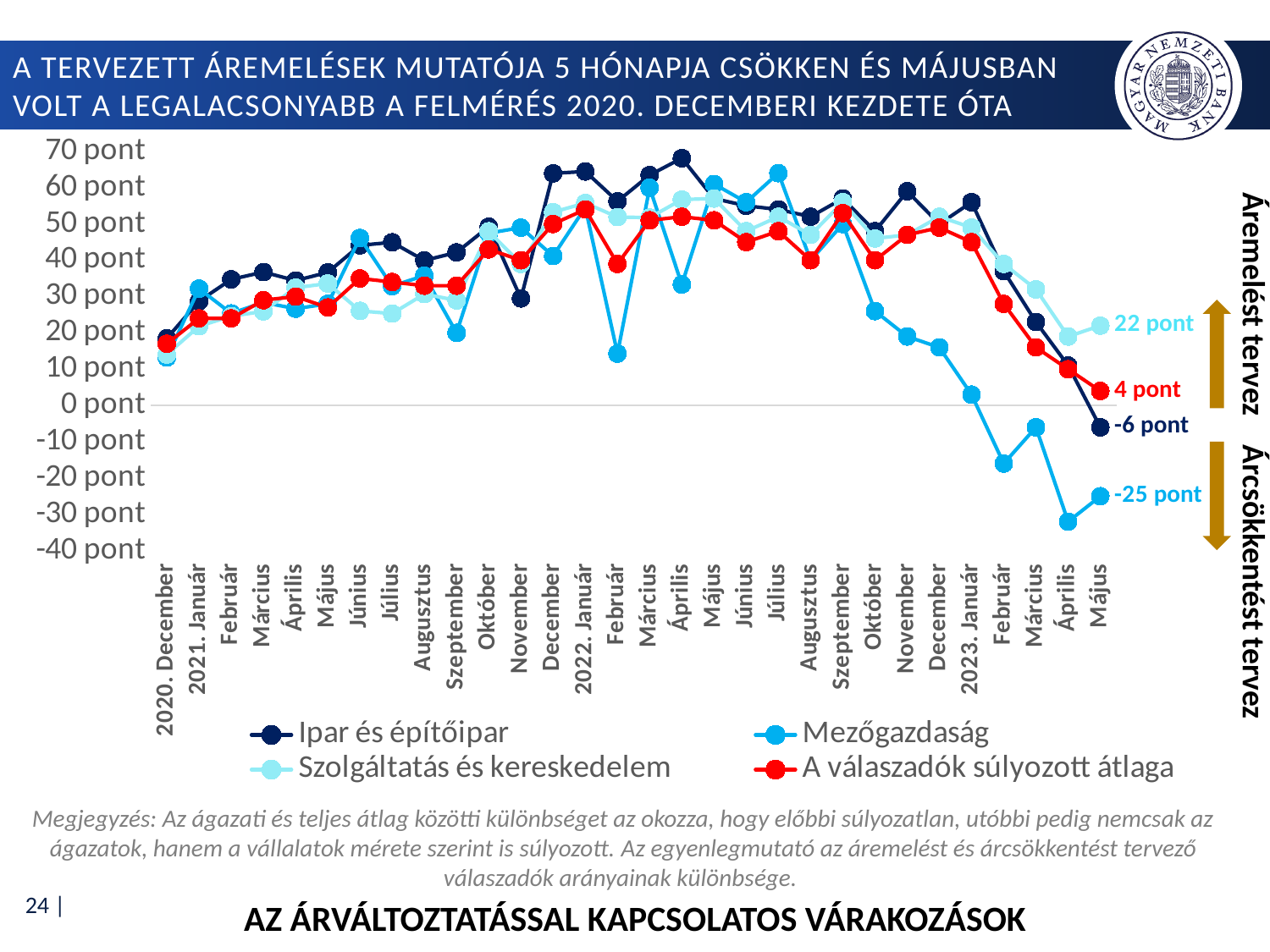
What is the value for A válaszadók súlyozott átlaga at the last point (Május 2023)? 4 pont Is the value for Ipar és építőipar in Április 2022 greater or less than 60 pont? greater What is the difference between Szolgáltatás és kereskedelem and Mezőgazdaság at the last point (Május 2023)? 47 pont What is the value for Mezőgazdaság at the last point (Május 2023)? -25 pont At the last point (Május 2023), which is larger: Ipar és építőipar or Mezőgazdaság? Ipar és építőipar What is the value for Ipar és építőipar at the last point (Május 2023)? -6 pont What is the value for Szolgáltatás és kereskedelem in Május 2023 (the last point)? 22 pont Which series has the highest value at the last point (Május 2023)? Szolgáltatás és kereskedelem What kind of chart is shown on the slide? line chart How many series does the legend list? 4 Which series has the lowest value at the last point (Május 2023)? Mezőgazdaság Do the values for A válaszadók súlyozott átlaga rise or fall from 2023. Január to Május? fall